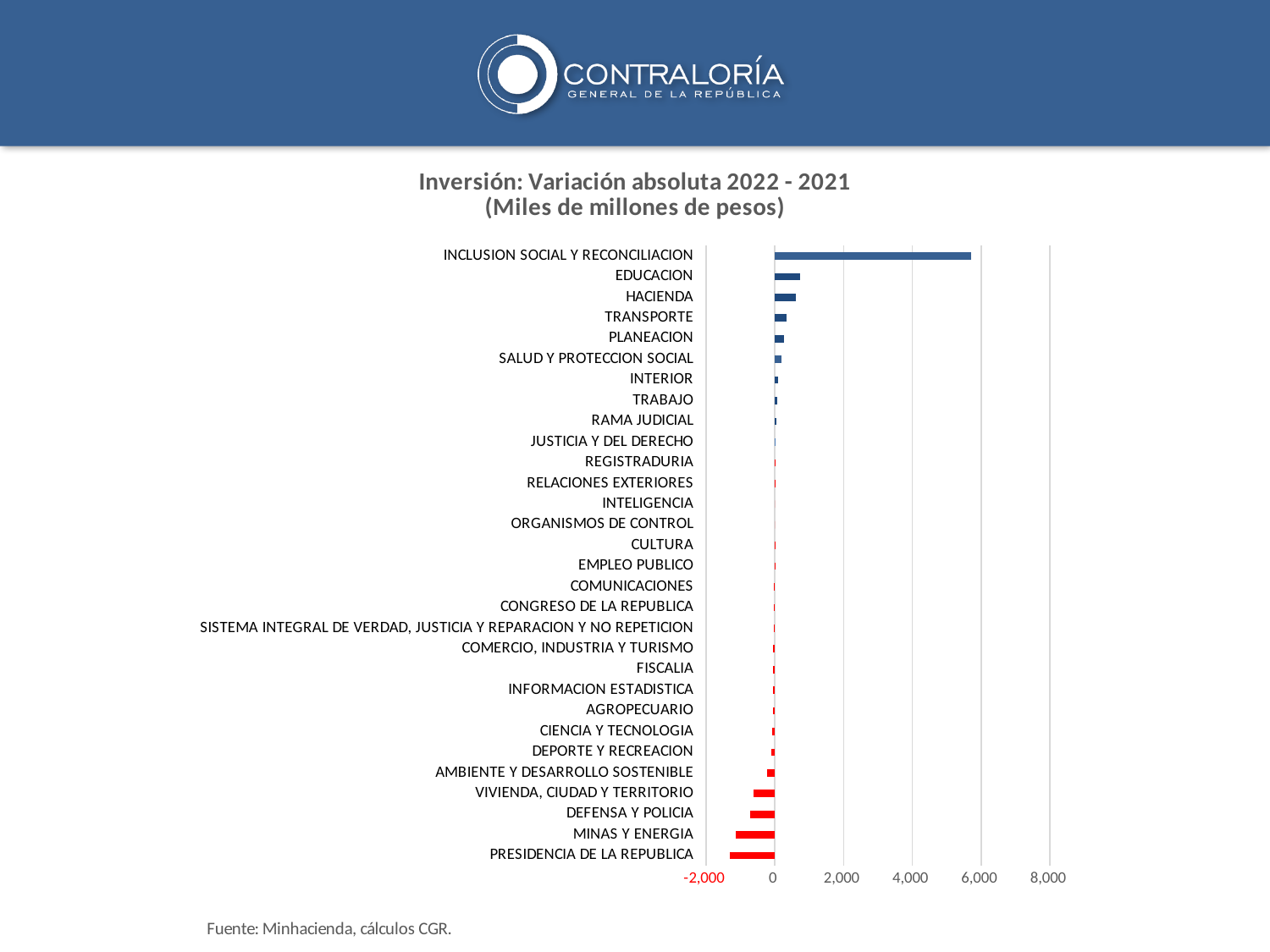
Which has the larger value, EDUCACION or TRANSPORTE? EDUCACION Is the value for PRESIDENCIA DE LA REPUBLICA greater or less than 0? less What colour are the bars with negative values in the chart? Red Is the value for EDUCACION greater or less than 2,000? less What is the title of the chart? Inversión: Variación absoluta 2022 - 2021 (Miles de millones de pesos) Do the values rise or fall as you move from the top category to the bottom category of the chart? fall Which sector has the highest value in the chart? INCLUSION SOCIAL Y RECONCILIACION Is the value for INCLUSION SOCIAL Y RECONCILIACION greater or less than 4,000? greater How many categories (sectors) are plotted in the chart? 30 What kind of chart is shown on the slide? Bar chart Which has the larger value, HACIENDA or DEFENSA Y POLICIA? HACIENDA